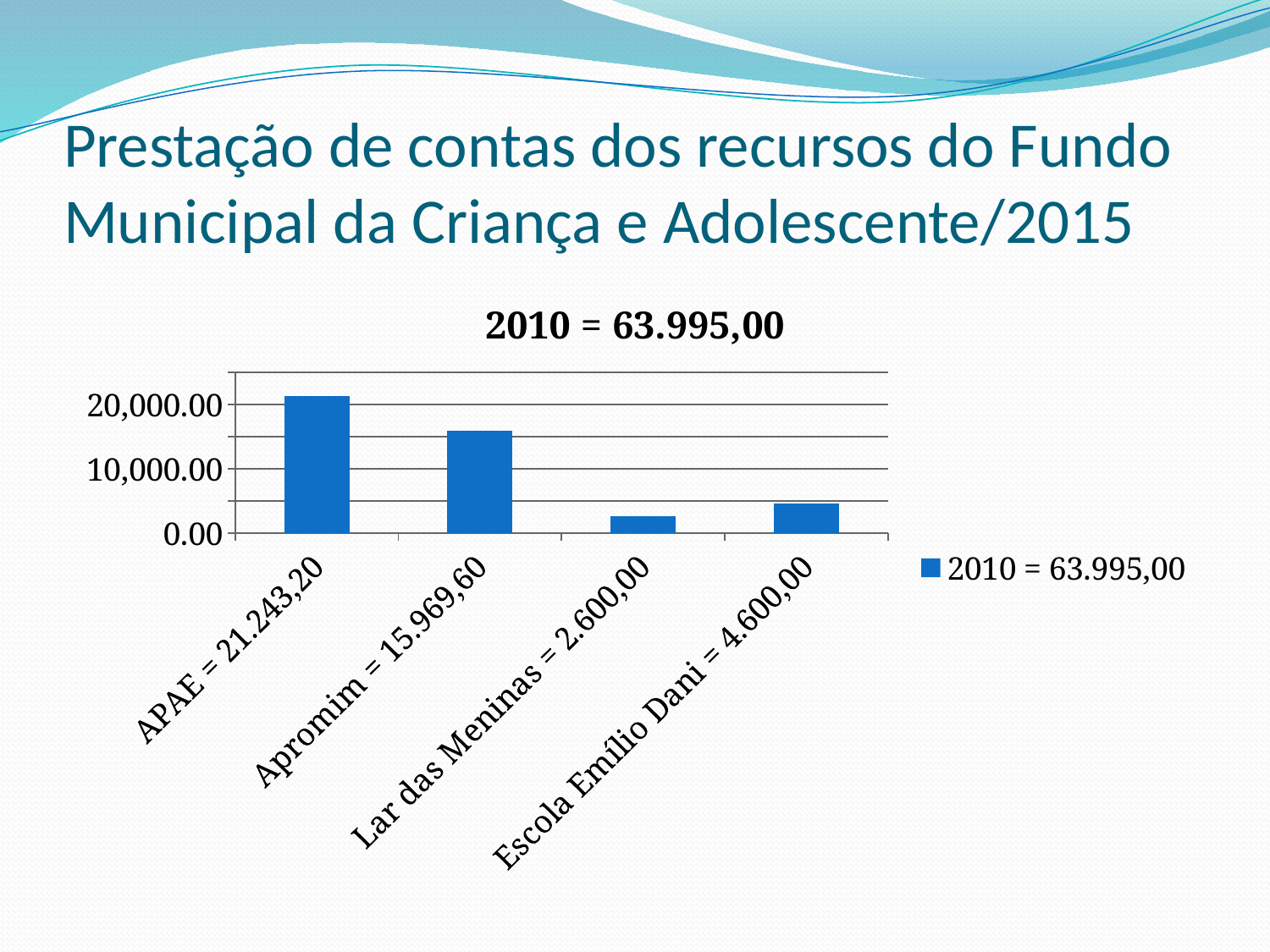
What is the title of the chart? 2010 = 63.995,00 What value is given for APAE in the category label? 21.243,20 What value is given for Escola Emílio Dani in the category label? 4.600,00 What value is given for Apromim in the category label? 15.969,60 What value is given for Lar das Meninas in the category label? 2.600,00 Is the value for Apromim greater or less than 10,000.00? greater What kind of chart is shown on the slide? bar chart How many series does the legend list? 1 How many categories (bars) does the chart show? 4 Which category has the lowest bar? Lar das Meninas Which category has the highest bar? APAE Which is larger, the value for Escola Emílio Dani or the value for Lar das Meninas? Escola Emílio Dani